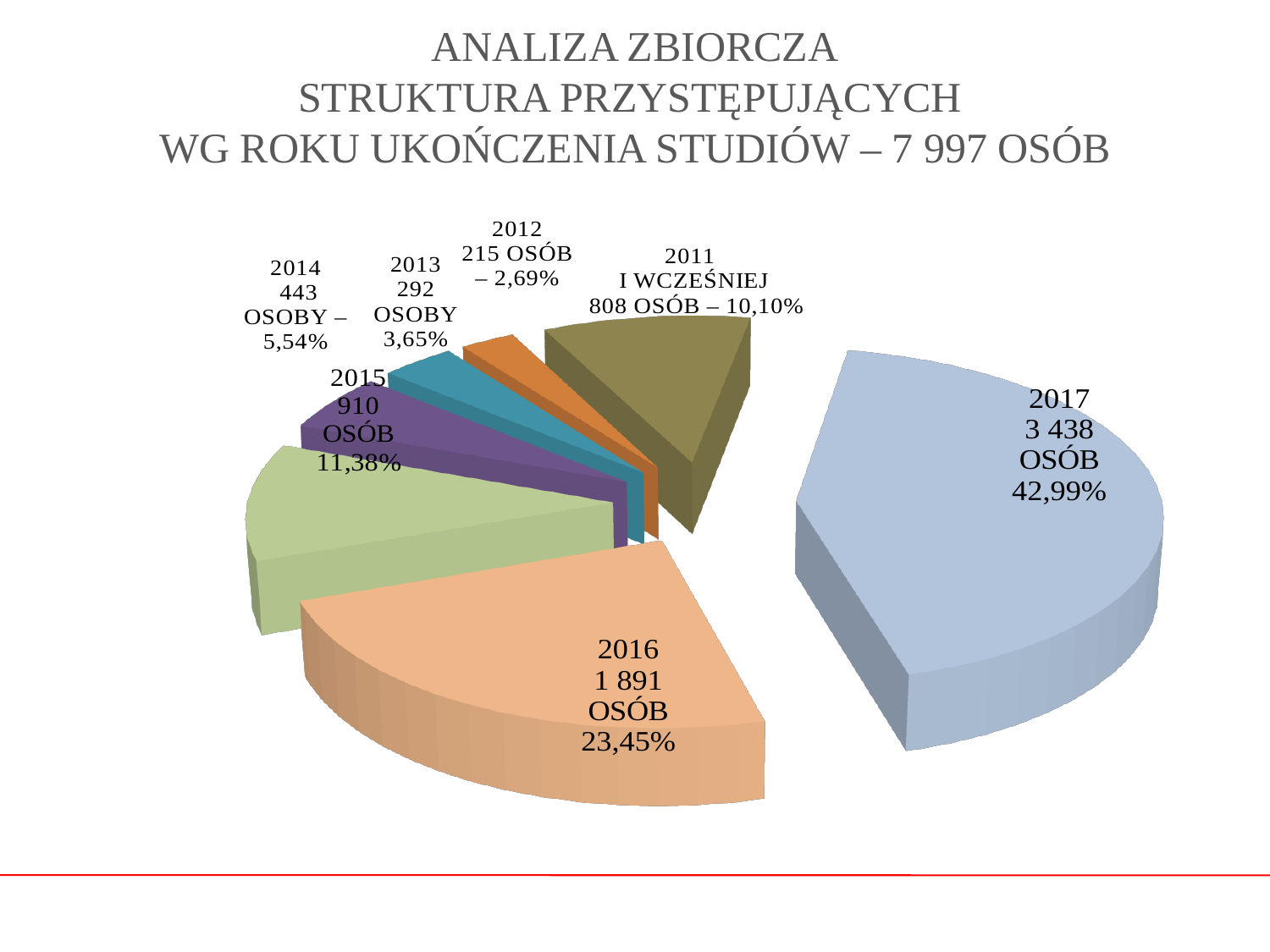
Which year has the largest slice of the pie? 2017 How many people are in the 2013 slice? 292 What percentage share does the 2012 slice have? 2,69% What percentage share does the 2014 slice have? 5,54% What percentage share does the 2016 slice have? 23,45% What is the difference in number of people between the 2017 and 2016 slices? 1 547 Which year has the smallest slice of the pie? 2012 What kind of chart is shown on the slide? pie chart How many people are in the '2011 i wcześniej' slice? 808 How many people are in the 2015 slice? 910 How many people are in the 2017 slice? 3 438 How many slices does the pie chart have? 7